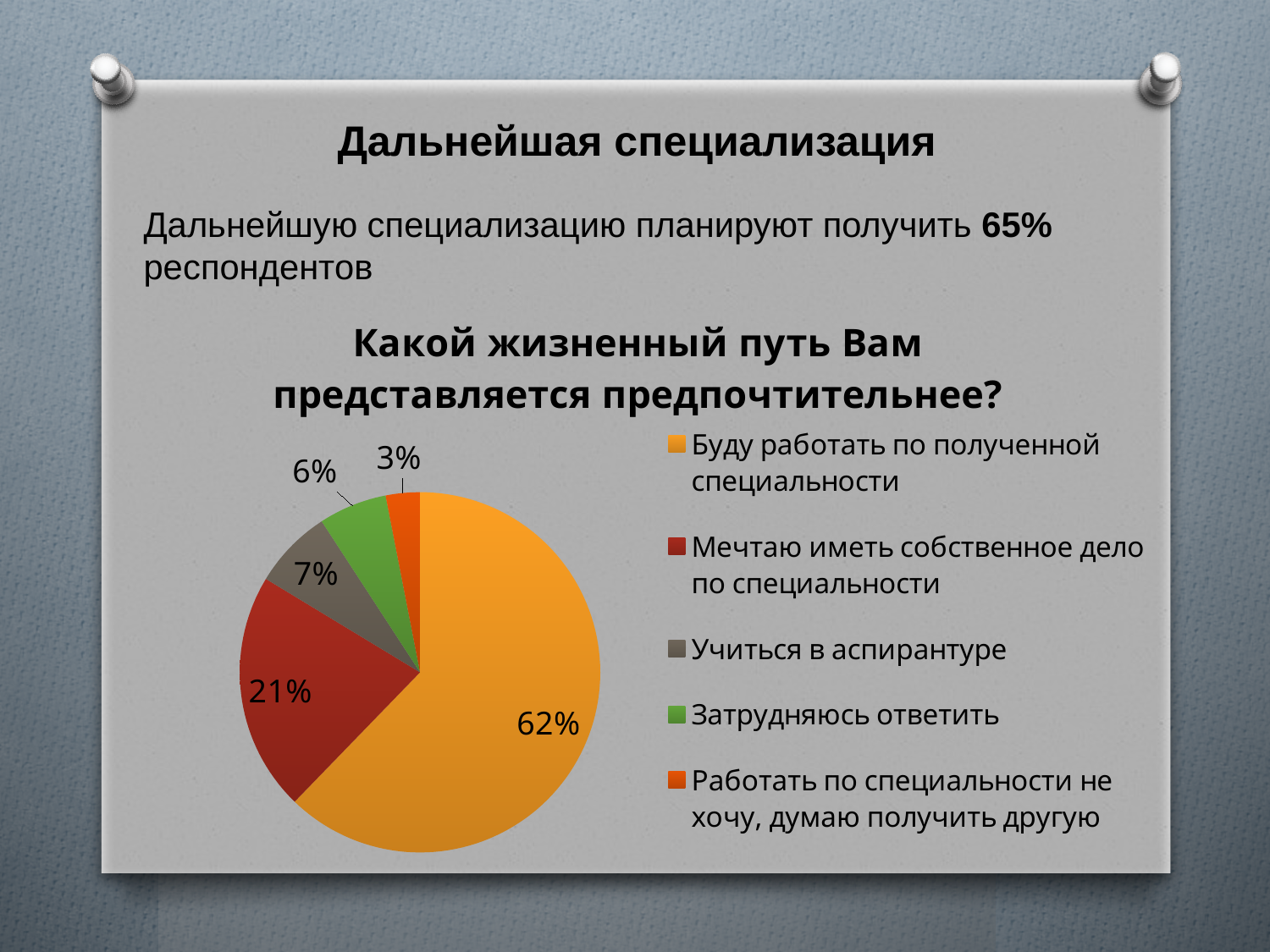
What share of respondents chose "Работать по специальности не хочу, думаю получить другую"? 3% What share of respondents chose "Буду работать по полученной специальности"? 62% What share of respondents chose "Затрудняюсь ответить"? 6% How many categories does the pie chart show? 5 Which is larger: the share for "Учиться в аспирантуре" or the share for "Затрудняюсь ответить"? Учиться в аспирантуре What type of chart is shown on the slide? pie chart What share of respondents chose "Мечтаю иметь собственное дело по специальности"? 21% What is the difference between the shares for "Буду работать по полученной специальности" and "Мечтаю иметь собственное дело по специальности"? 41% What share of respondents chose "Учиться в аспирантуре"? 7% Which category has the largest slice of the pie? Буду работать по полученной специальности What is the title of the chart? Какой жизненный путь Вам представляется предпочтительнее? Which category has the smallest slice of the pie? Работать по специальности не хочу, думаю получить другую